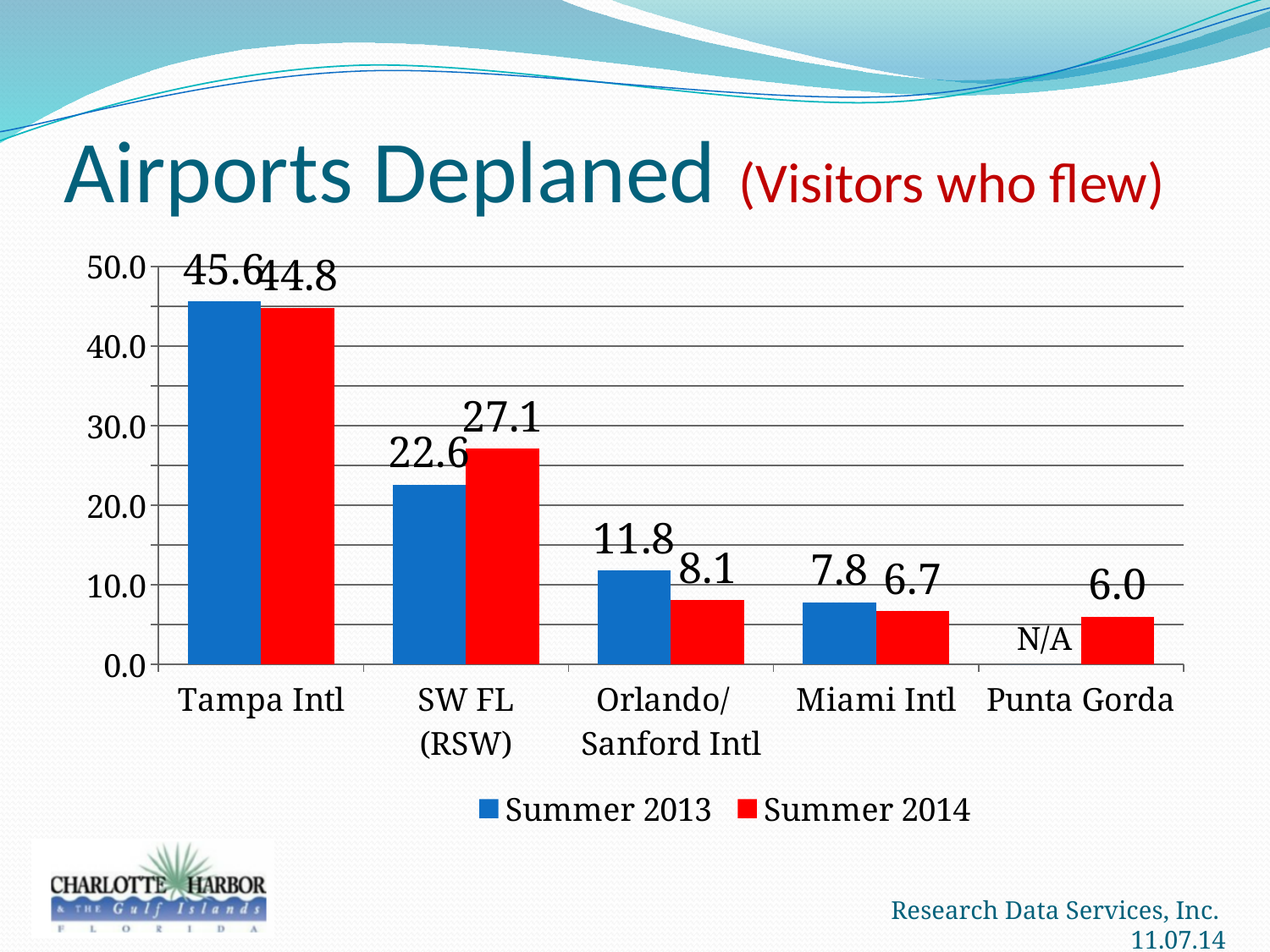
How many airports are shown on the x axis? 5 What is the Summer 2014 value for SW FL (RSW)? 27.1 What is the difference between the Summer 2013 and Summer 2014 values for Tampa Intl? 0.8 What is shown for Punta Gorda in Summer 2013? N/A How many series does the legend list? 2 What is the Summer 2014 value for Punta Gorda? 6.0 Is the Summer 2013 value for Tampa Intl greater or less than 40.0? greater What is the Summer 2013 value for Orlando/Sanford Intl? 11.8 What kind of chart is shown on the slide? Bar chart Which airport has the highest Summer 2014 value? Tampa Intl Which is larger for SW FL (RSW): the Summer 2013 value or the Summer 2014 value? Summer 2014 Which airport has the lowest Summer 2013 value among those with a value shown? Miami Intl